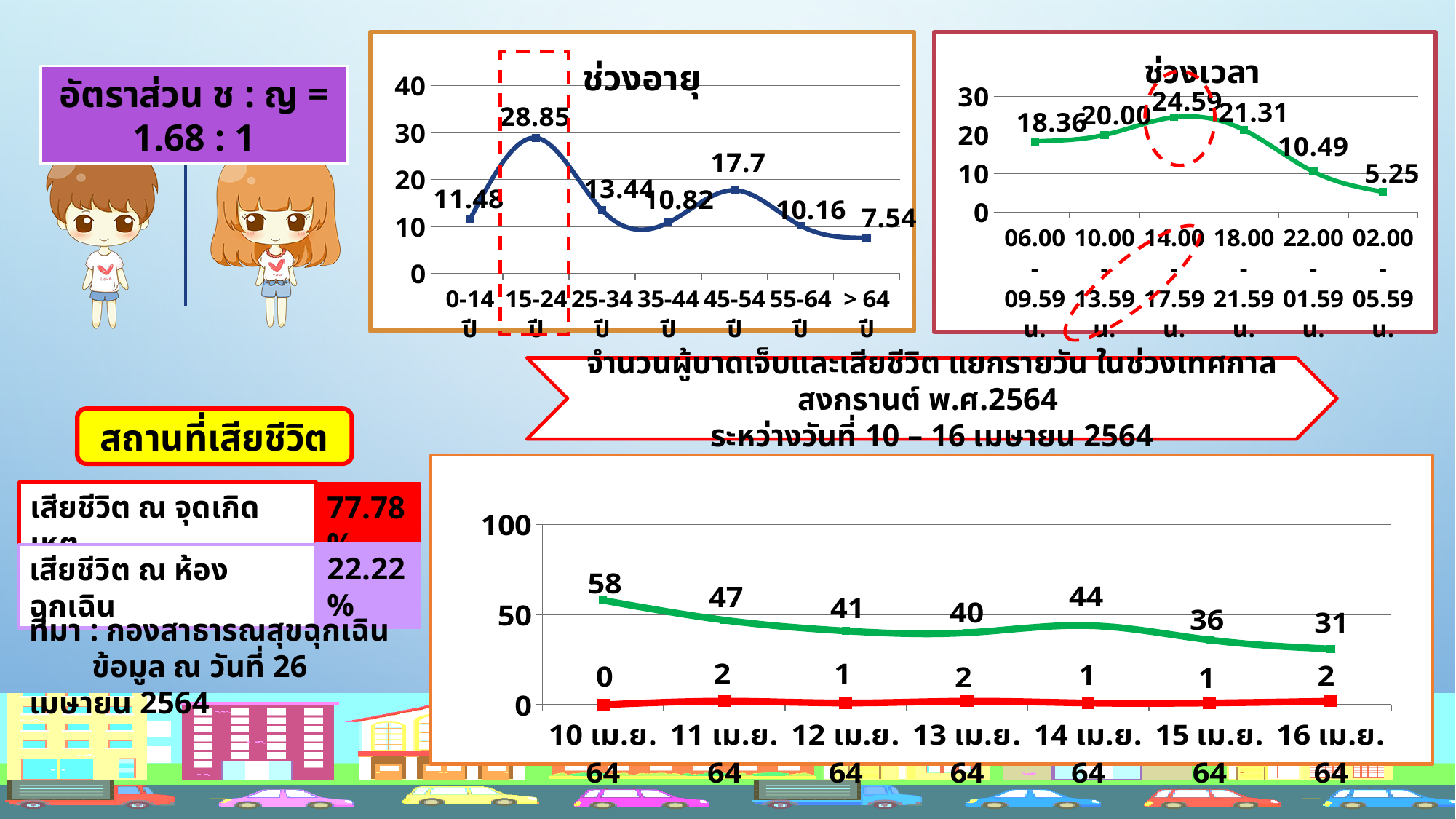
In the ช่วงเวลา chart, do the values rise or fall from 18.00-21.59 น. to 02.00-05.59 น.? fall In the ช่วงอายุ chart, what is the value for the 15-24 ปี age group? 28.85 In the bottom chart (10 – 16 เมษายน 2564), what is the difference between the green line values on 10 เม.ย. 64 and 16 เม.ย. 64? 27 In the ช่วงเวลา chart, what is the value for the 14.00-17.59 น. time period? 24.59 In the bottom chart (10 – 16 เมษายน 2564), what is the value of the green line on 10 เม.ย. 64? 58 What type of chart is the ช่วงอายุ chart? line chart In the bottom chart (10 – 16 เมษายน 2564), what is the value of the red line on 13 เม.ย. 64? 2 In the ช่วงอายุ chart, which age group has the lowest value? > 64 ปี In the ช่วงอายุ chart, how many age groups are plotted? 7 In the ช่วงเวลา chart, which time period has the highest value? 14.00-17.59 น. In the ช่วงเวลา chart, which is larger, the value for 06.00-09.59 น. or 22.00-01.59 น.? 06.00-09.59 น. In the ช่วงอายุ chart, what is the difference between the values for 15-24 ปี and 45-54 ปี? 11.15